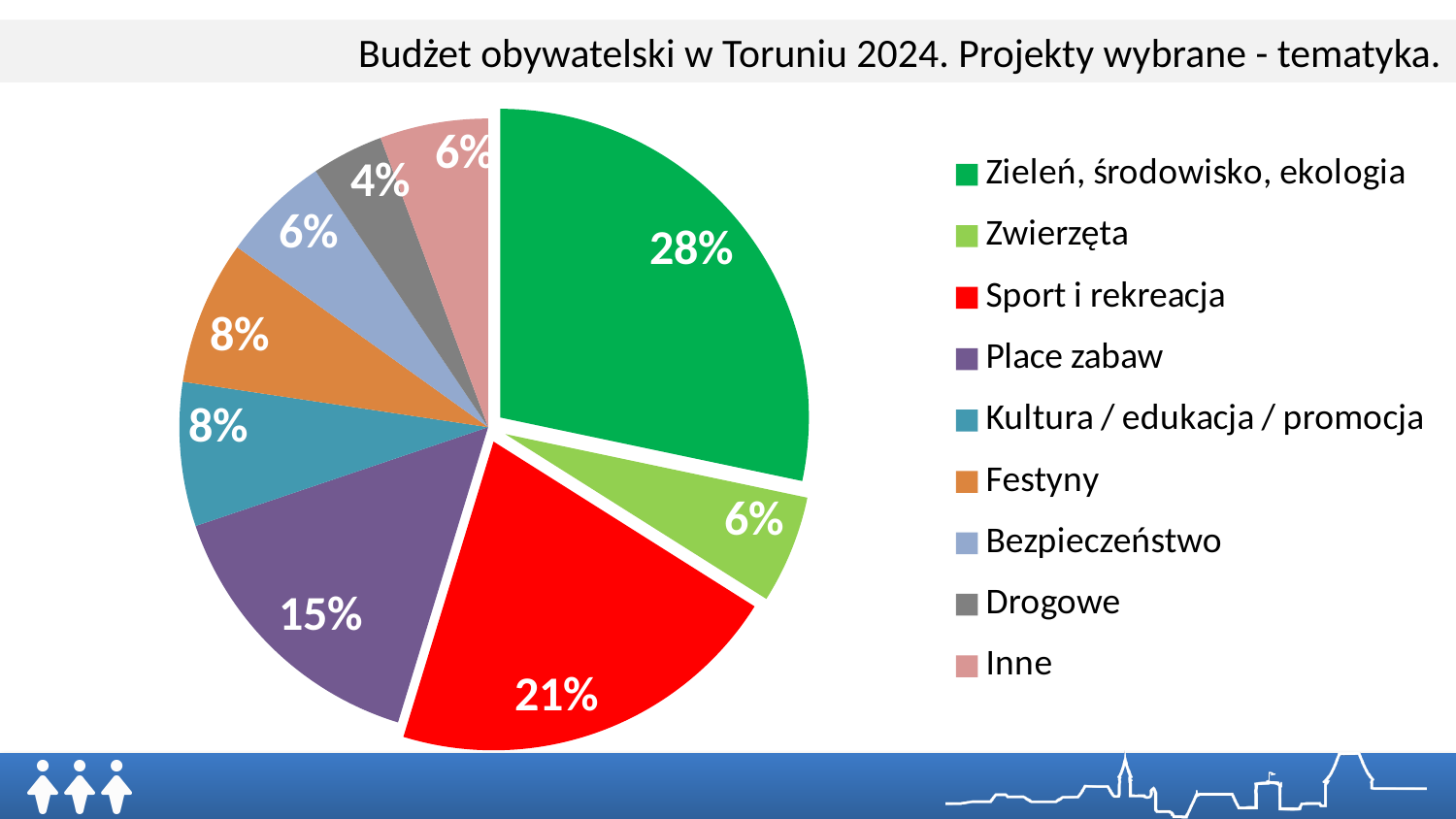
What is the value shown for "Place zabaw"? 15% Which is larger, the share for "Place zabaw" or the share for "Kultura / edukacja / promocja"? Place zabaw What is the title of the chart? Budżet obywatelski w Toruniu 2024. Projekty wybrane - tematyka. How many categories does the legend list? 9 What type of chart is shown on the slide? pie chart What is the value shown for "Drogowe"? 4% What is the difference between the shares of "Zieleń, środowisko, ekologia" and "Sport i rekreacja"? 7% Which category has the largest slice of the pie? Zieleń, środowisko, ekologia What is the value shown for "Festyny"? 8% What share of the pie does "Sport i rekreacja" have? 21% Which category has the smallest slice of the pie? Drogowe What share of the pie does "Zieleń, środowisko, ekologia" have? 28%